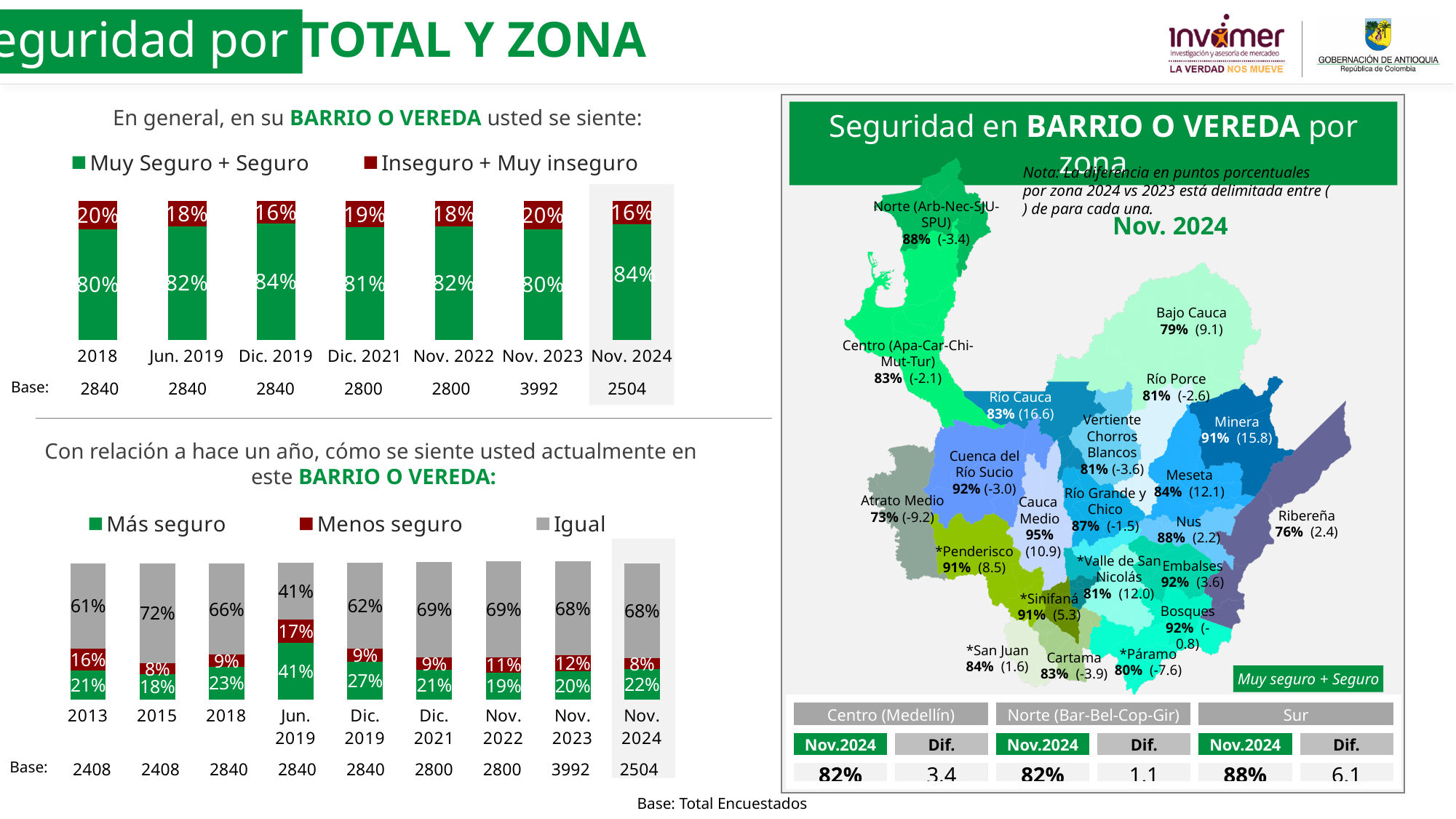
In the top chart ('En general, en su BARRIO O VEREDA usted se siente'), how many time periods are shown on the x axis? 7 In the top chart ('En general, en su BARRIO O VEREDA usted se siente'), how many series does the legend list? 2 In the top chart ('En general, en su BARRIO O VEREDA usted se siente'), what is the value of 'Inseguro + Muy inseguro' for Dic. 2021? 19% What type of chart is the bottom chart ('Con relación a hace un año...')? Stacked bar chart In the bottom chart ('Con relación a hace un año...'), how many series does the legend list? 3 In the top chart ('En general, en su BARRIO O VEREDA usted se siente'), what is the difference between the 'Muy Seguro + Seguro' values for Nov. 2024 and Nov. 2023? 4 percentage points In the top chart ('En general, en su BARRIO O VEREDA usted se siente'), what is the value of 'Muy Seguro + Seguro' for Nov. 2024? 84% In the bottom chart ('Con relación a hace un año...'), what is the 'Igual' value for 2015? 72% In the bottom chart ('Con relación a hace un año...'), is the 'Menos seguro' value larger for 2013 or for Nov. 2024? 2013 In the bottom chart ('Con relación a hace un año...'), which period has the lowest 'Igual' value? Jun. 2019 In the bottom chart ('Con relación a hace un año...'), which period has the highest 'Más seguro' value? Jun. 2019 In the top chart ('En general, en su BARRIO O VEREDA usted se siente'), which period has the highest 'Inseguro + Muy inseguro' value? 2018 and Nov. 2023 (20%)